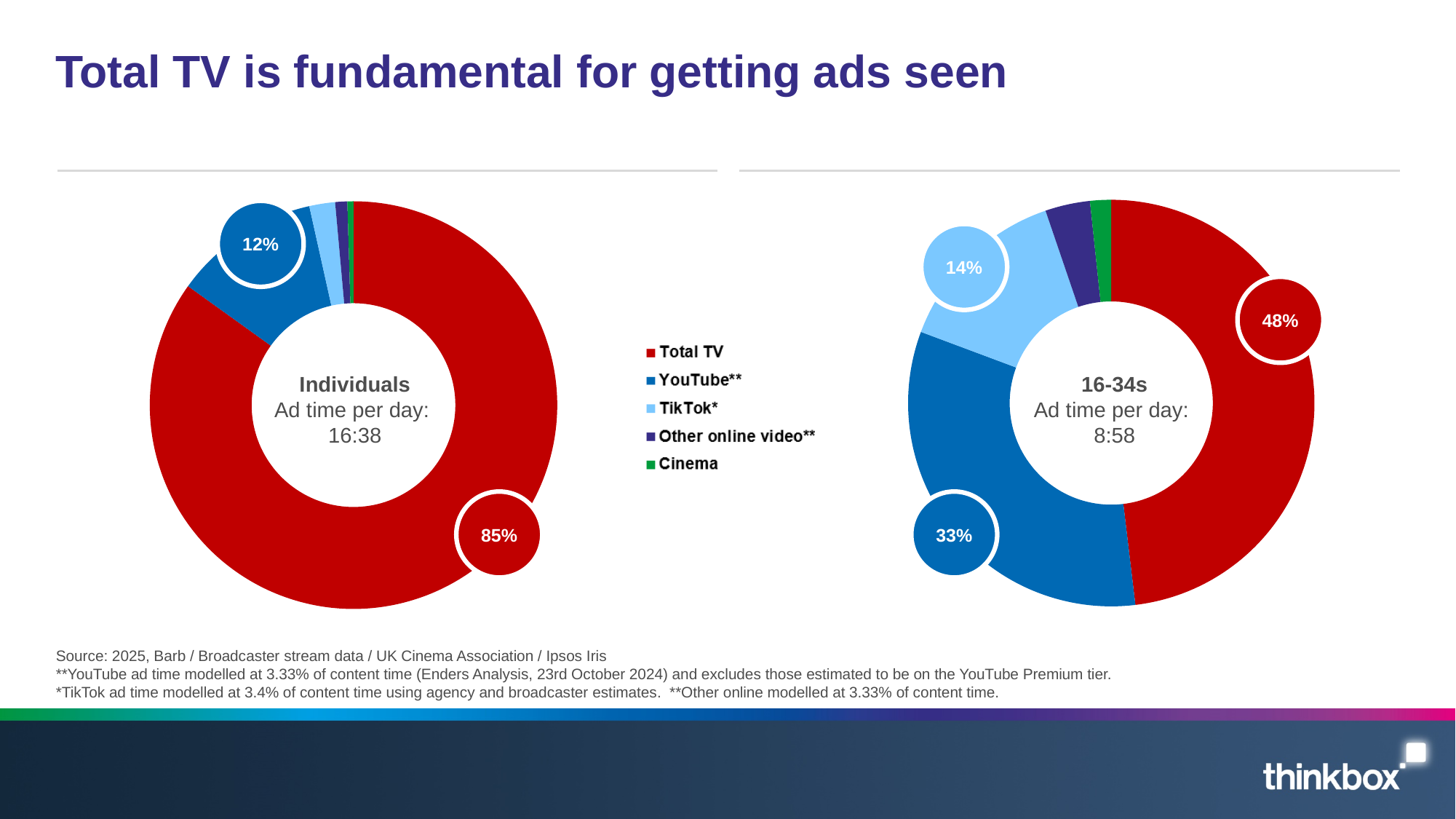
In the Individuals chart, what share of ad time per day is YouTube? 12% In the Individuals chart, what share of ad time per day is Total TV? 85% How many categories does the legend list? 5 In the 16-34s chart, what share of ad time per day is Total TV? 48% Which is larger in the 16-34s chart: the YouTube share or the TikTok share? YouTube In the Individuals chart, which category has the largest share? Total TV In the 16-34s chart, what is the difference between the Total TV share and the YouTube share? 15 percentage points In the 16-34s chart, what share of ad time per day is YouTube? 33% In the 16-34s chart, which category has the largest share? Total TV What is the ad time per day shown in the centre of the 16-34s chart? 8:58 What type of chart is used on this slide? Pie (donut) chart In the 16-34s chart, what share of ad time per day is TikTok? 14%